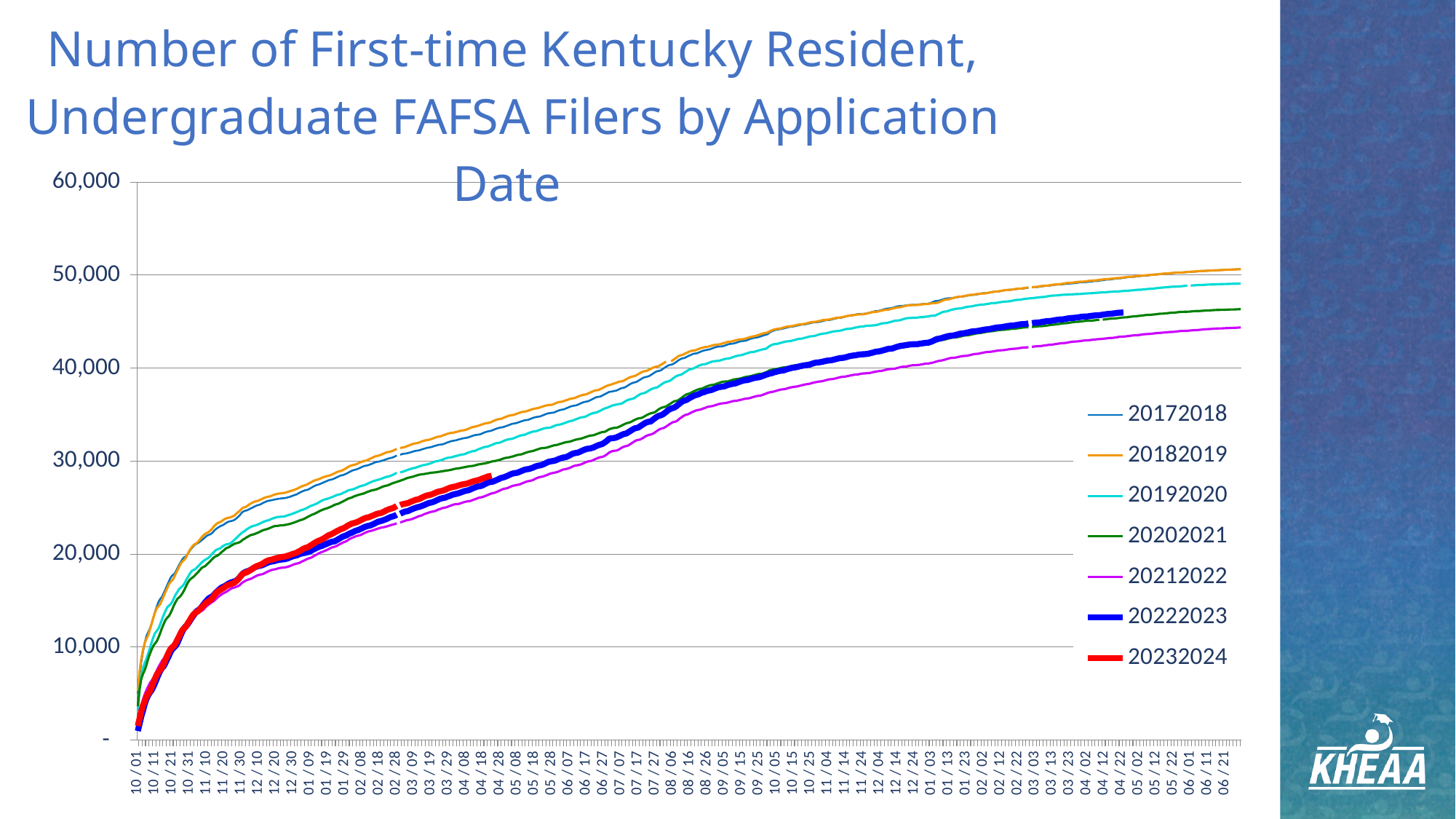
Among the series that extend to the end of the x axis, which has the lowest final value? 20212022 Do the values for the 20182019 series rise or fall along the x axis? rise How many series does the legend list? 7 Is the final value of the 20212022 series greater or less than 40,000? greater At the end of the x axis, which series is higher: 20182019 or 20212022? 20182019 Which series is drawn as a thick red line? 20232024 Around 02/28, which series is higher: 20172018 or 20212022? 20172018 Is the final value of the 20212022 series greater or less than 50,000? less Is the last plotted value of the 20232024 series greater or less than 30,000? less What kind of chart is shown on the slide? line chart What is the title of the chart? Number of First-time Kentucky Resident, Undergraduate FAFSA Filers by Application Date